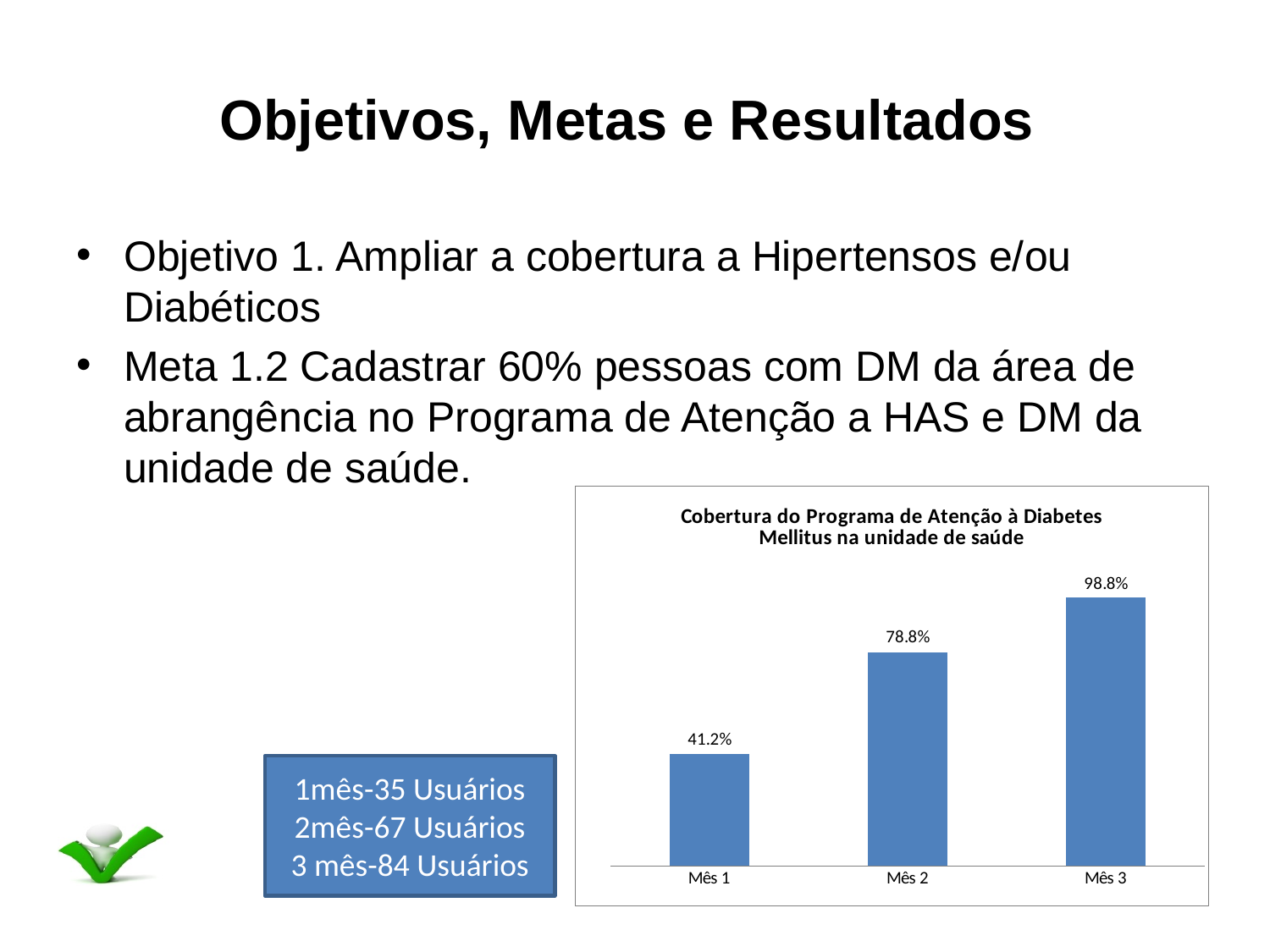
What is the value for Mês 2? 78.8% Which is larger, the value for Mês 2 or the value for Mês 3? Mês 3 What is the difference between the values for Mês 2 and Mês 1? 37.6% Do the values rise or fall from Mês 1 to Mês 3? Rise What is the title of the chart? Cobertura do Programa de Atenção à Diabetes Mellitus na unidade de saúde What is the value for Mês 1? 41.2% How many months are shown on the x axis of the chart? 3 What kind of chart is shown on the slide? Bar chart Which month has the lowest coverage value? Mês 1 Which month has the highest coverage value? Mês 3 What is the value for Mês 3? 98.8% What is the difference between the values for Mês 3 and Mês 1? 57.6%